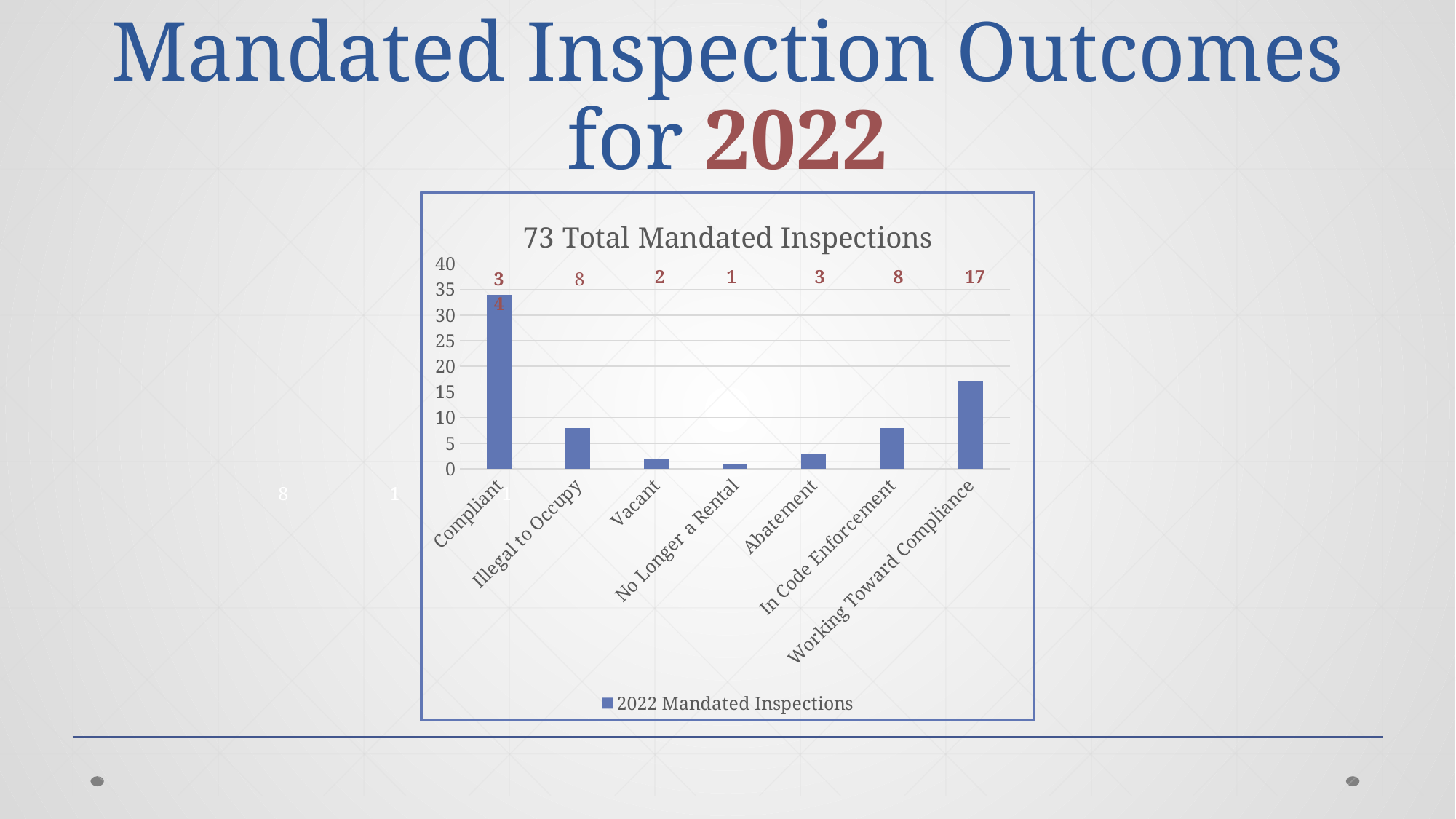
How many series does the legend list? 1 What is the value for Illegal to Occupy? 8 What is the difference between the values for Working Toward Compliance and In Code Enforcement? 9 Which is larger, the value for Vacant or the value for Abatement? Abatement How many categories are shown on the x axis? 7 What is the value for Working Toward Compliance? 17 What is the value for Abatement? 3 What kind of chart is shown? bar chart Is the value for Compliant greater or less than 30? greater What is the value for No Longer a Rental? 1 Which category has the highest value? Compliant Which category has the lowest value? No Longer a Rental